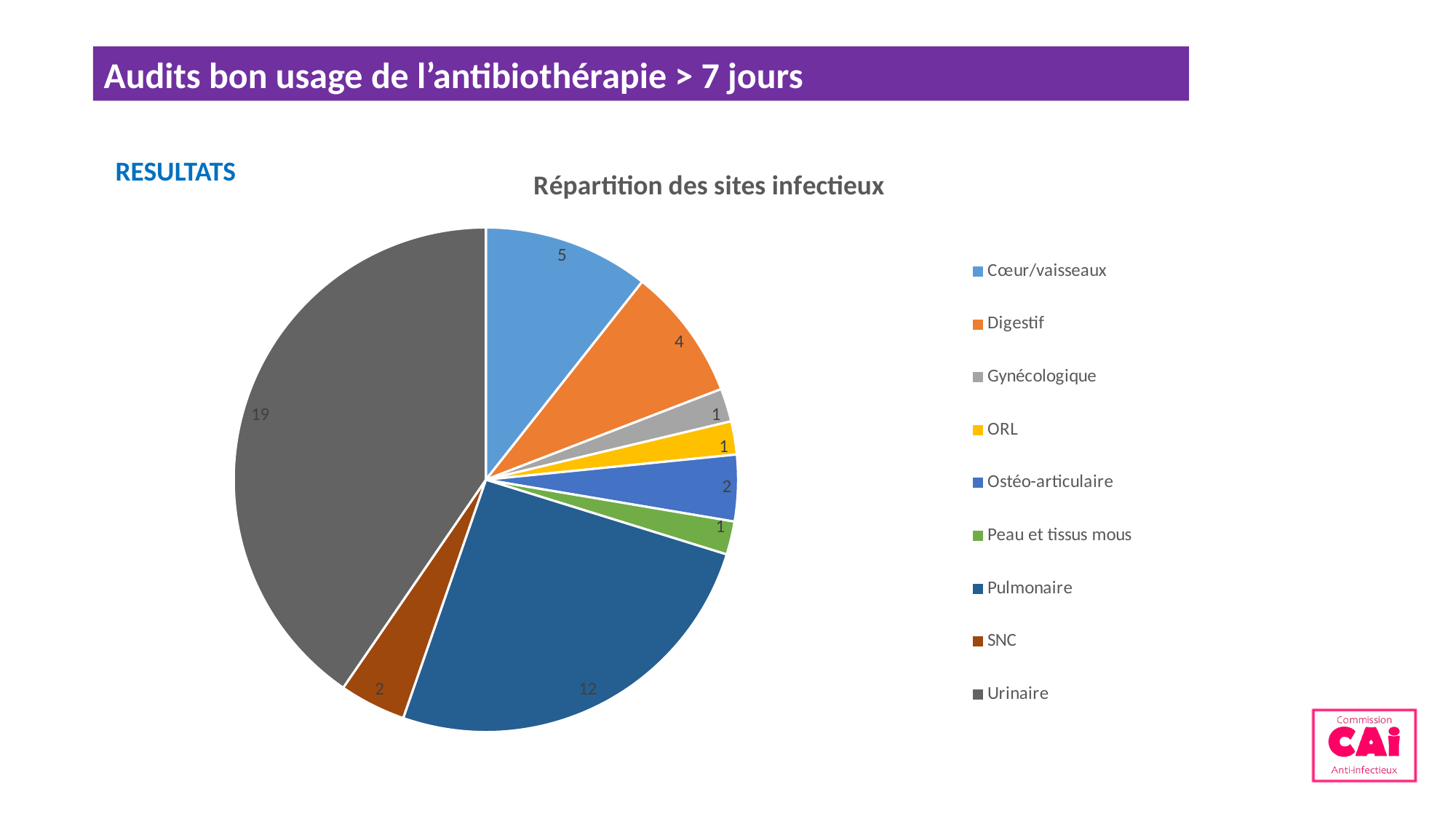
Which is larger, the value for Cœur/vaisseaux or the value for Digestif? Cœur/vaisseaux What is the difference between the values for Urinaire and Pulmonaire? 7 What is the value for SNC in the pie chart? 2 What is the value for Digestif in the pie chart? 4 What kind of chart is shown on the slide? Pie chart What is the value for Cœur/vaisseaux in the pie chart? 5 What is the total of all the values shown in the pie chart? 47 How many categories does the legend of the pie chart list? 9 What is the value for Pulmonaire in the pie chart? 12 What is the value for Urinaire in the pie chart 'Répartition des sites infectieux'? 19 Which category has the largest slice in the pie chart? Urinaire What is the title of the chart on the slide? Répartition des sites infectieux